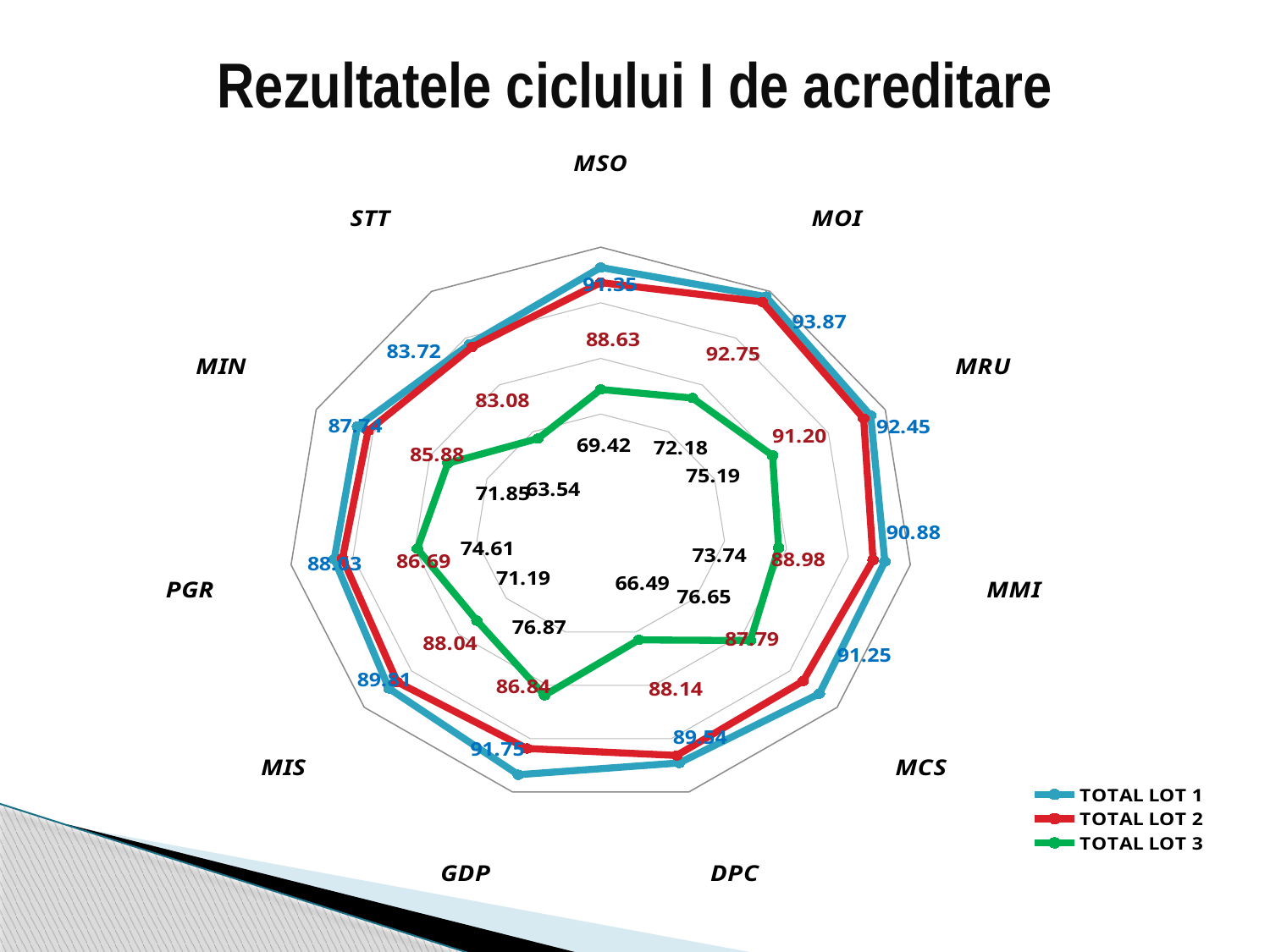
For MMI, which is larger: the TOTAL LOT 2 value or the TOTAL LOT 3 value? TOTAL LOT 2 How many categories (axes) does the radar chart have? 11 What is the TOTAL LOT 1 value for STT? 83.72 What is the TOTAL LOT 2 value for MRU? 91.20 What is the title of the slide? Rezultatele ciclului I de acreditare What is the TOTAL LOT 1 value for MOI? 93.87 What is the difference between the TOTAL LOT 1 and TOTAL LOT 2 values for MOI? 1.12 What type of chart is shown on the slide? Radar chart Which category has the highest TOTAL LOT 1 value? MOI What is the TOTAL LOT 3 value for DPC? 66.49 How many series does the legend list? 3 Which category has the lowest TOTAL LOT 3 value? STT